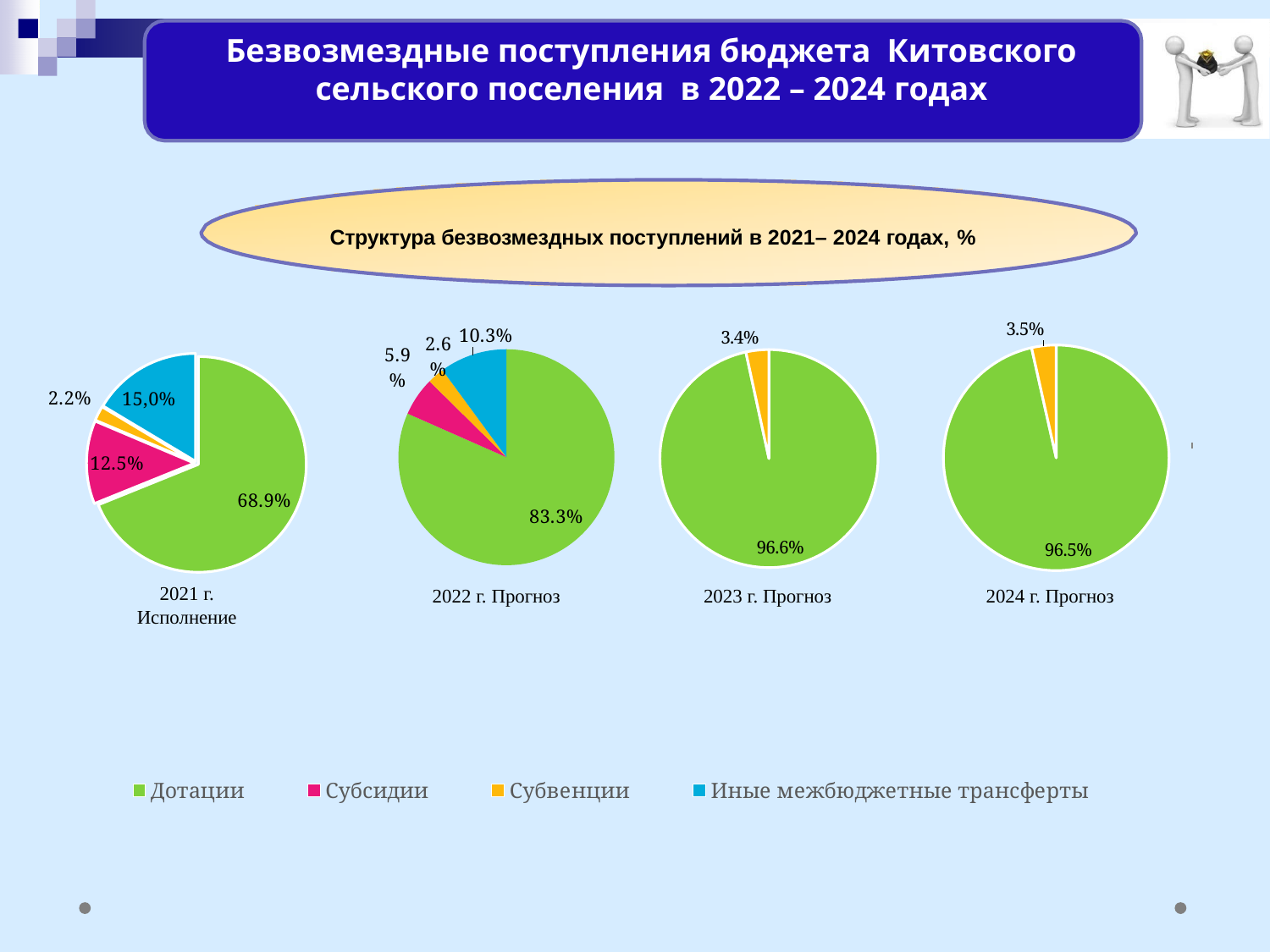
In the 2022 г. Прогноз pie chart, what share is labelled for Иные межбюджетные трансферты? 10.3% What type of chart is used to show the structure of receipts for each year? Pie chart In the 2022 г. Прогноз pie chart, what share is labelled for Дотации? 83.3% In the 2021 г. Исполнение pie chart, what share is labelled for Субсидии? 12.5% In the 2022 г. Прогноз pie chart, which category has the largest slice? Дотации In the 2024 г. Прогноз pie chart, what share is labelled for Дотации? 96.5% What is the difference between the Дотации share in the 2022 г. Прогноз chart and the Дотации share in the 2021 г. Исполнение chart? 14.4 percentage points In the 2021 г. Исполнение pie chart, what share is labelled for Дотации? 68.9% In the 2021 г. Исполнение pie chart, which category has the smallest slice? Субвенции In the 2021 г. Исполнение pie chart, what share is labelled for Иные межбюджетные трансферты? 15,0% In the 2023 г. Прогноз pie chart, what share is labelled for Субвенции? 3.4% How many categories does the legend list for the pie charts? 4